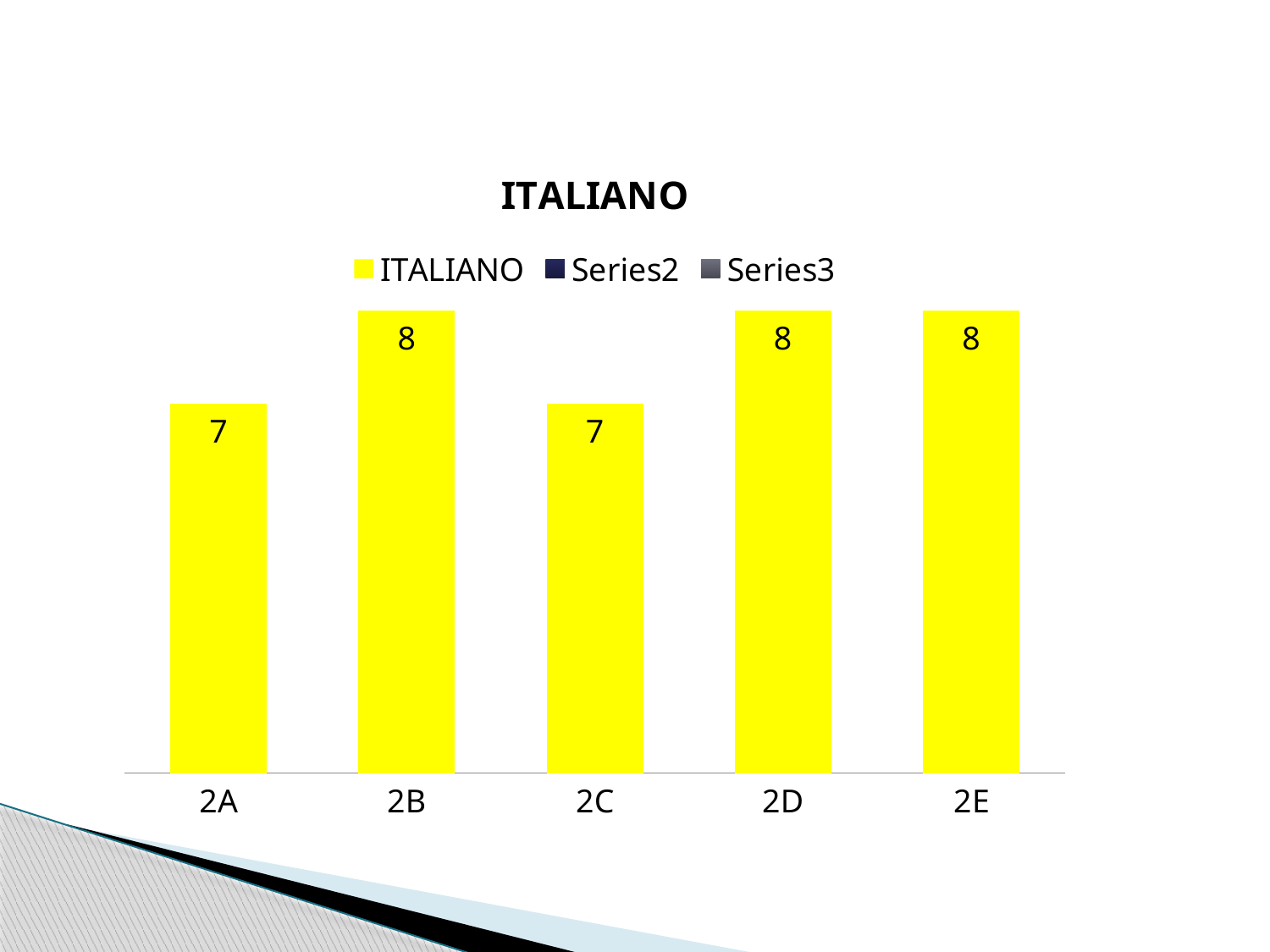
What is the value for 2C? 7 What is the value for 2D? 8 Which is larger, the value for 2C or the value for 2D? 2D How many categories are shown on the x axis? 5 What is the value for 2B? 8 What is the difference between the values for 2B and 2A? 1 Which is larger, the value for 2A or the value for 2B? 2B What is the value for 2E? 8 What is the title of the chart? ITALIANO What is the value for 2A? 7 How many series does the legend list? 3 What kind of chart is shown? bar chart